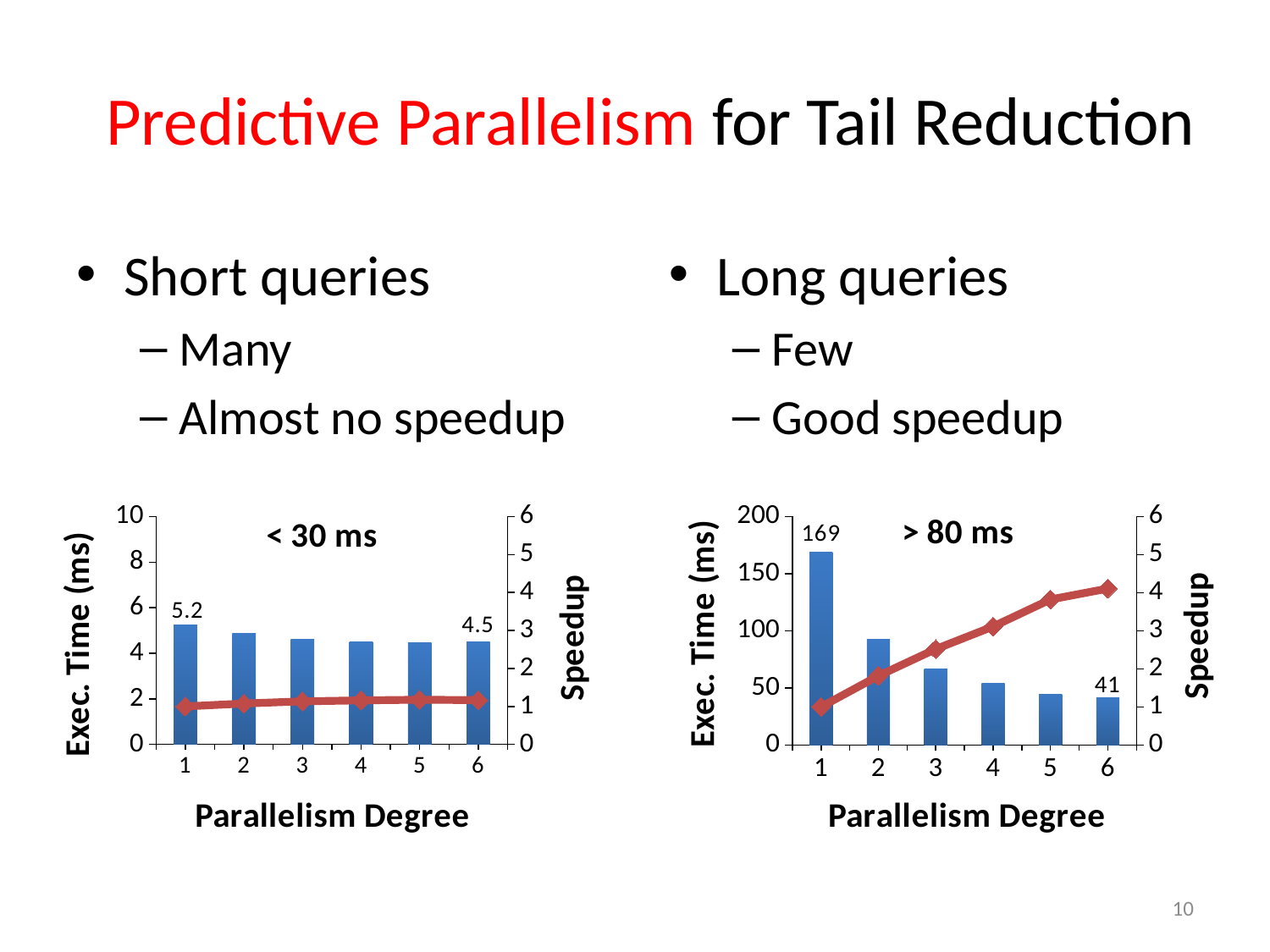
In the "> 80 ms" chart on the right, by how much does execution time drop from parallelism degree 1 to degree 6? 128 In the "> 80 ms" chart on the right, what is the execution time at parallelism degree 6? 41 In the "< 30 ms" chart on the left, what is the difference in execution time between parallelism degree 1 and degree 6? 0.7 In the "> 80 ms" chart on the right, is the execution time at parallelism degree 2 greater or less than 50? greater In the "< 30 ms" chart on the left, what is the execution time at parallelism degree 1? 5.2 In the "> 80 ms" chart on the right, which parallelism degree has the highest execution time? 1 In the "< 30 ms" chart on the left, what is the execution time at parallelism degree 6? 4.5 In the "> 80 ms" chart on the right, does the speedup line rise or fall as parallelism degree increases? rise In the "> 80 ms" chart on the right, is the speedup at parallelism degree 5 greater or less than 3? greater In the "> 80 ms" chart on the right, which parallelism degree has the lowest execution time? 6 In the "> 80 ms" chart on the right, what is the execution time at parallelism degree 1? 169 How many parallelism degrees are plotted on the x axis of the "< 30 ms" chart on the left? 6